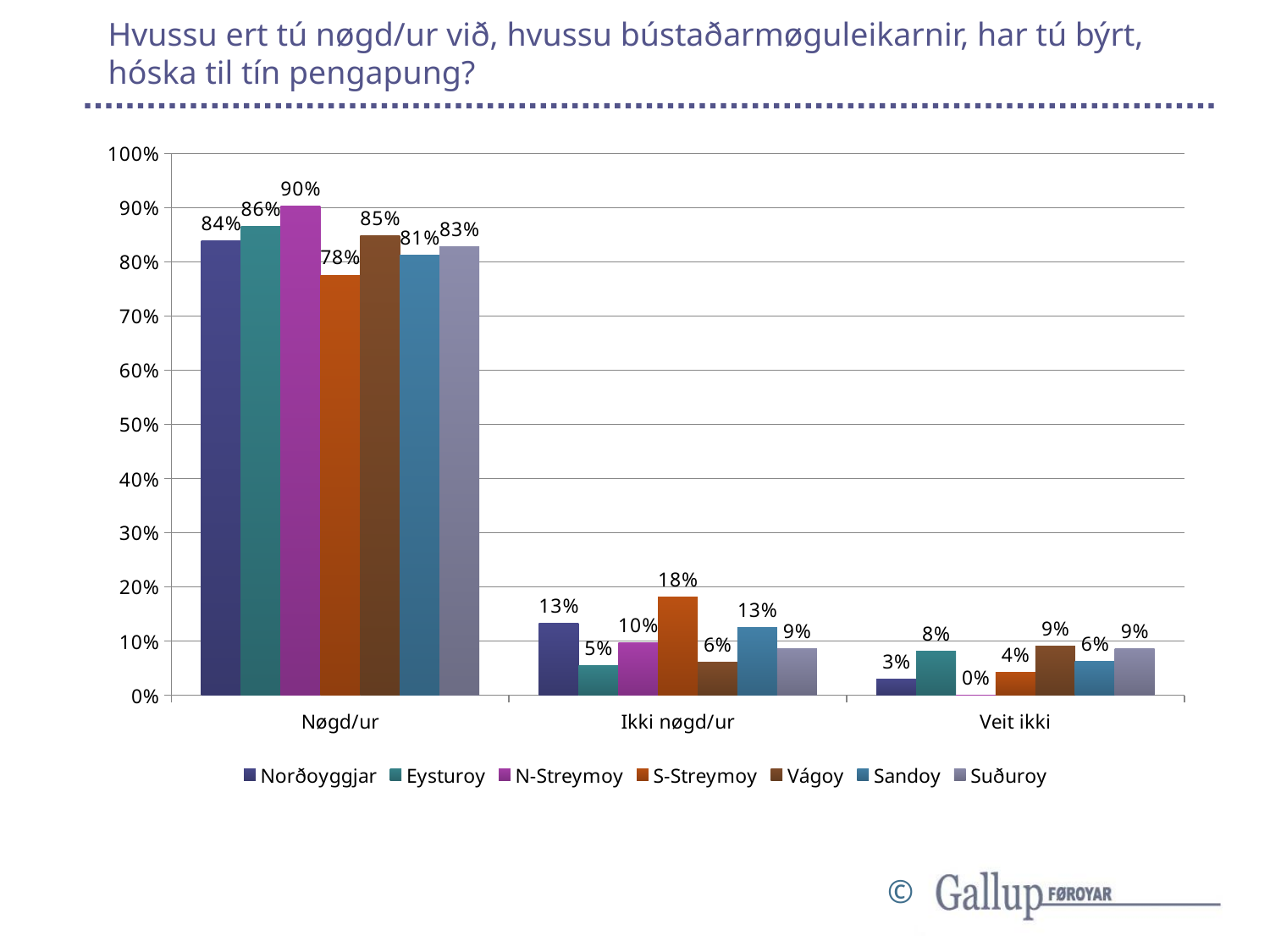
What kind of chart is shown on the slide? bar chart In the Ikki nøgd/ur category, which is larger: the value for Eysturoy or the value for Vágoy? Vágoy How many series does the legend list? 7 How many categories are shown on the x axis? 3 What is the value for N-Streymoy in the Veit ikki category? 0% What is the value for S-Streymoy in the Ikki nøgd/ur category? 18% Which series has the highest value in the Nøgd/ur category? N-Streymoy What is the value for N-Streymoy in the Nøgd/ur category? 90% What is the difference between the N-Streymoy and S-Streymoy values in the Nøgd/ur category? 12% Is the value for Sandoy in the Nøgd/ur category greater or less than 50%? greater Which series has the lowest value in the Nøgd/ur category? S-Streymoy Which series is shown in orange in the legend? S-Streymoy